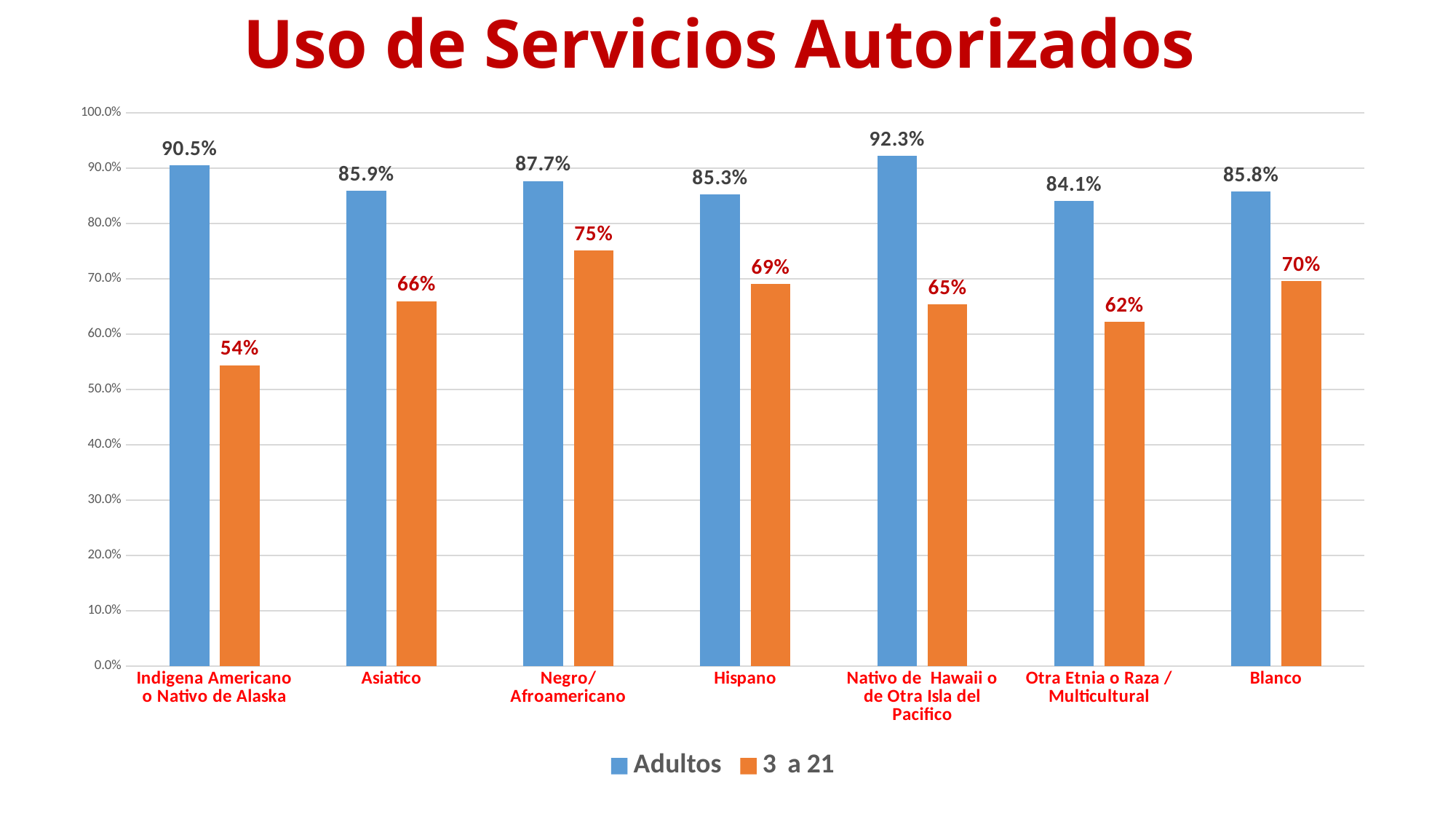
What is the title of the chart? Uso de Servicios Autorizados Which is larger: the 3 a 21 value for Asiatico or the 3 a 21 value for Hispano? Hispano What is the Adultos value for Otra Etnia o Raza / Multicultural? 84.1% Which colour represents the 3 a 21 series? Orange How many series does the legend list? 2 Which category has the highest Adultos value? Nativo de Hawaii o de Otra Isla del Pacifico How many categories are shown on the x axis? 7 What kind of chart is shown on the slide? Bar chart Which category has the lowest 3 a 21 value? Indigena Americano o Nativo de Alaska What is the difference between the Adultos and 3 a 21 values for Blanco? 15.8% What is the Adultos value for Hispano? 85.3% What is the 3 a 21 value for Negro/Afroamericano? 75%